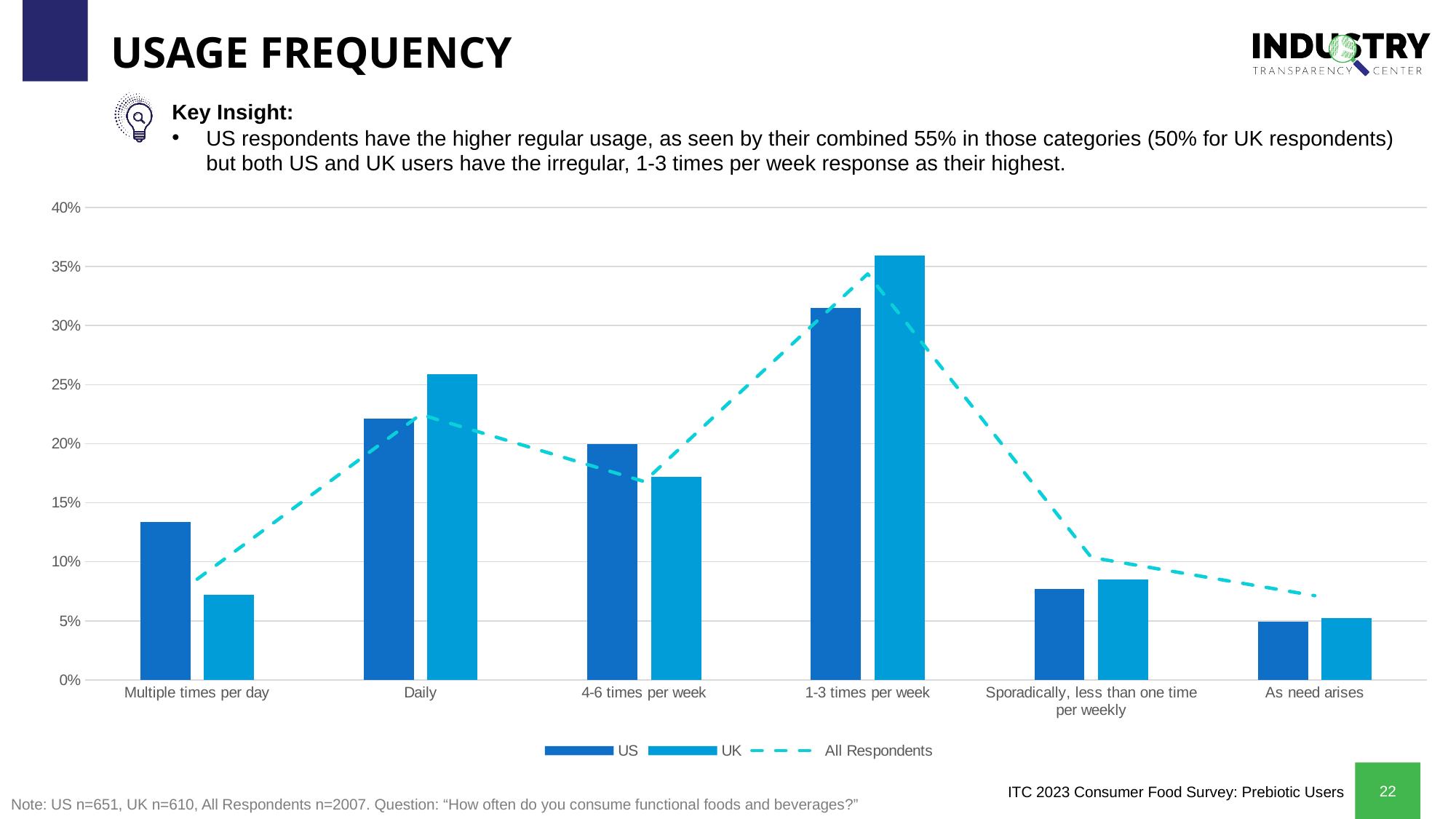
Which category has the highest value for US respondents? 1-3 times per week Which series is shown as a dashed line rather than bars? All Respondents For 'Daily', which is larger, the US bar or the UK bar? UK Is the US value for 'Multiple times per day' greater or less than 15%? less Which category has the lowest value for UK respondents? As need arises Which category has the lowest value for US respondents? As need arises What kind of chart is shown on the slide? combination bar and line chart How many usage frequency categories are shown on the x axis? 6 Is the UK value for '1-3 times per week' greater or less than 30%? greater How many series does the legend list? 3 For 'Multiple times per day', which is larger, the US bar or the UK bar? US Which category has the highest value for UK respondents? 1-3 times per week